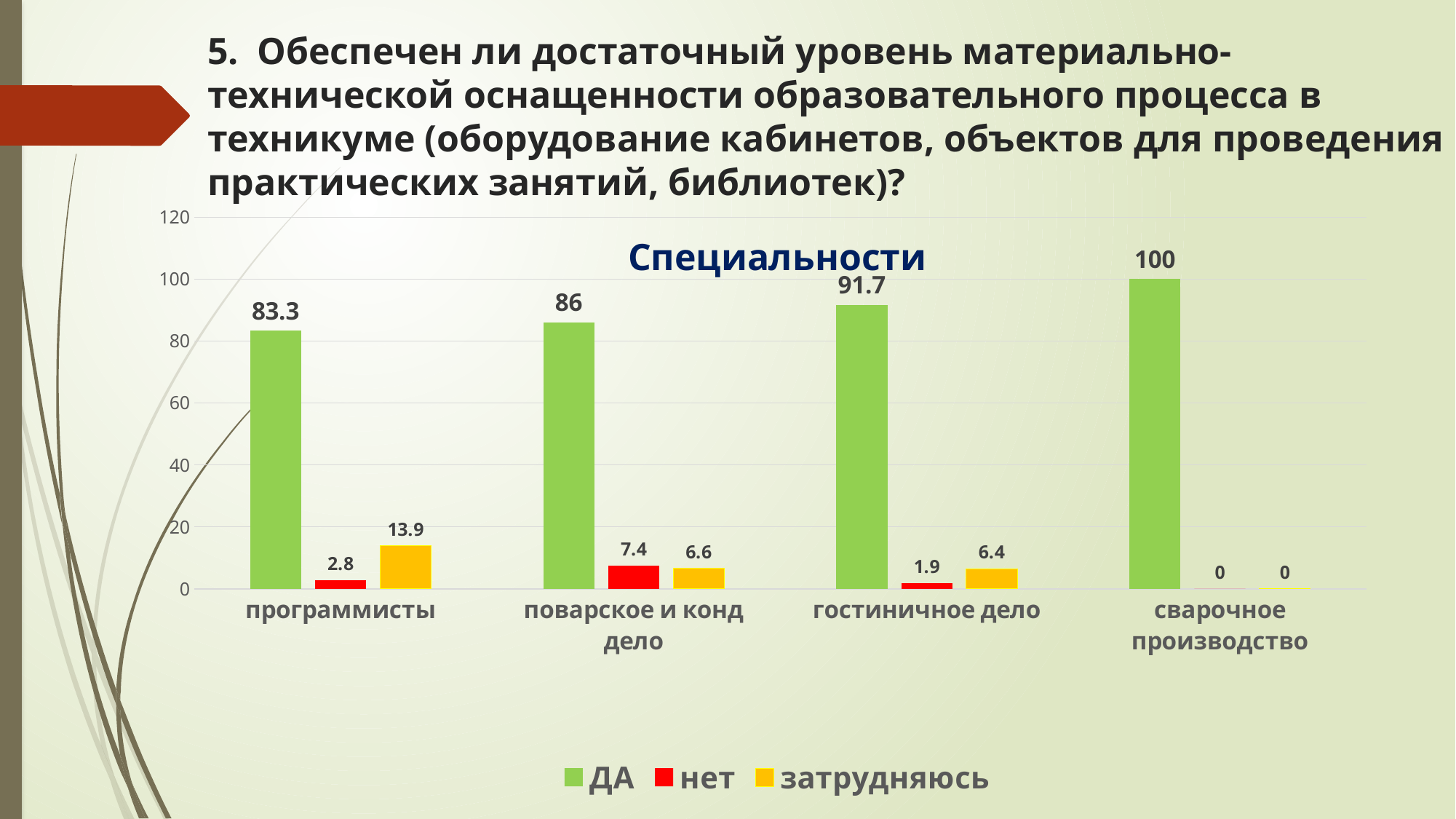
Is the ДА value for поварское и конд дело greater or less than 80? greater Which category has the highest ДА value? сварочное производство What is the value of нет for гостиничное дело? 1.9 What is the value of затрудняюсь for поварское и конд дело? 6.6 What kind of chart is shown? bar chart Which is larger for программисты: нет or затрудняюсь? затрудняюсь How many series does the legend list? 3 Which category has the lowest ДА value? программисты What is the value of ДА for программисты? 83.3 What is the title of the chart? Специальности What is the difference between the ДА values for гостиничное дело and поварское и конд дело? 5.7 How many categories are shown on the x axis? 4